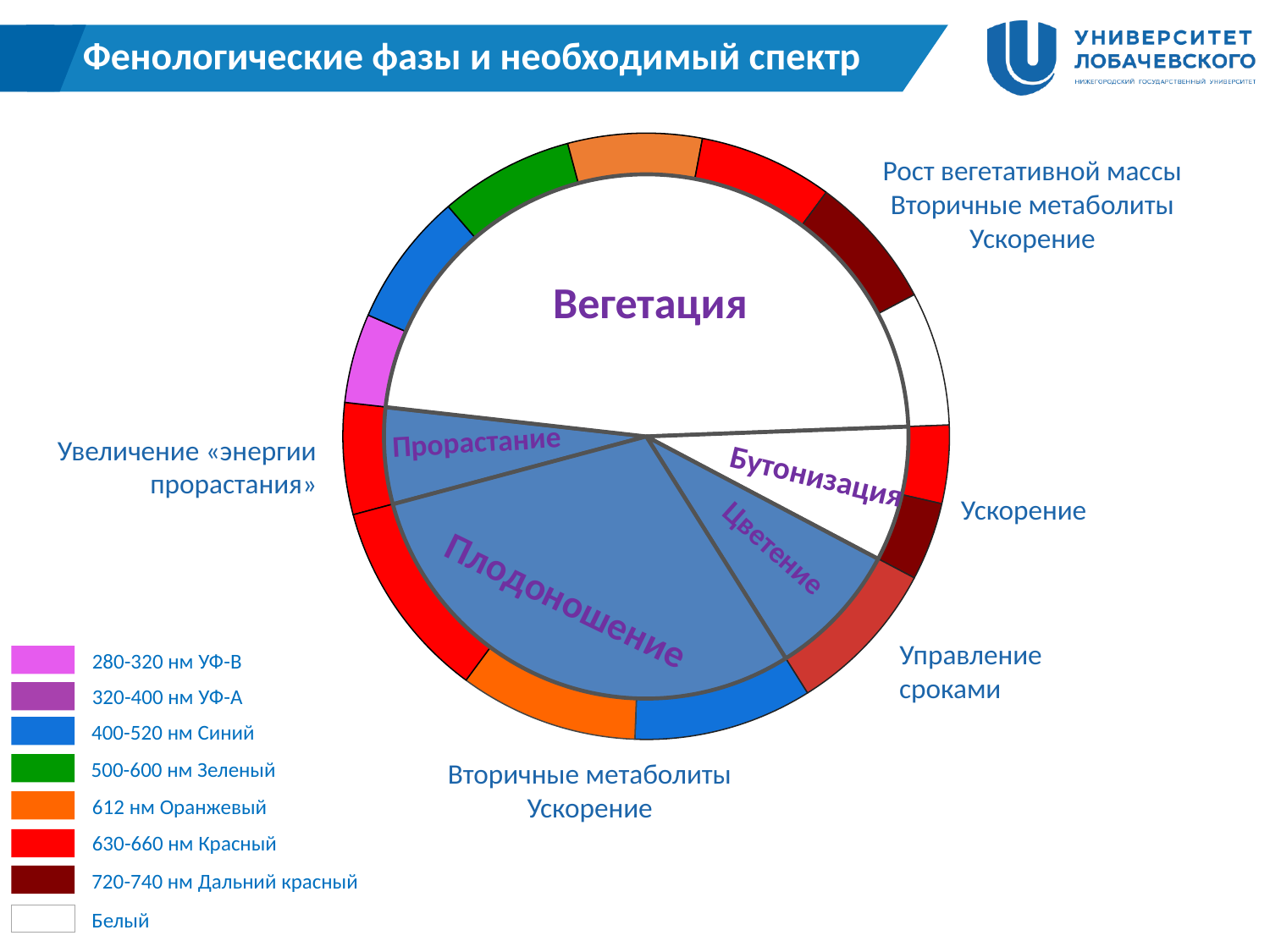
According to the legend, which wavelength range corresponds to Зеленый? 500-600 нм Which slice is larger, Вегетация or Плодоношение? Вегетация Which slice is larger, Плодоношение or Цветение? Плодоношение How many entries does the legend list? 8 Which phase occupies the largest slice of the pie chart? Вегетация What is the title of the slide containing the chart? Фенологические фазы и необходимый спектр What kind of chart is shown on the slide? pie chart How many phase slices does the pie chart have? 5 Which phase occupies the smallest slice of the pie chart? Прорастание